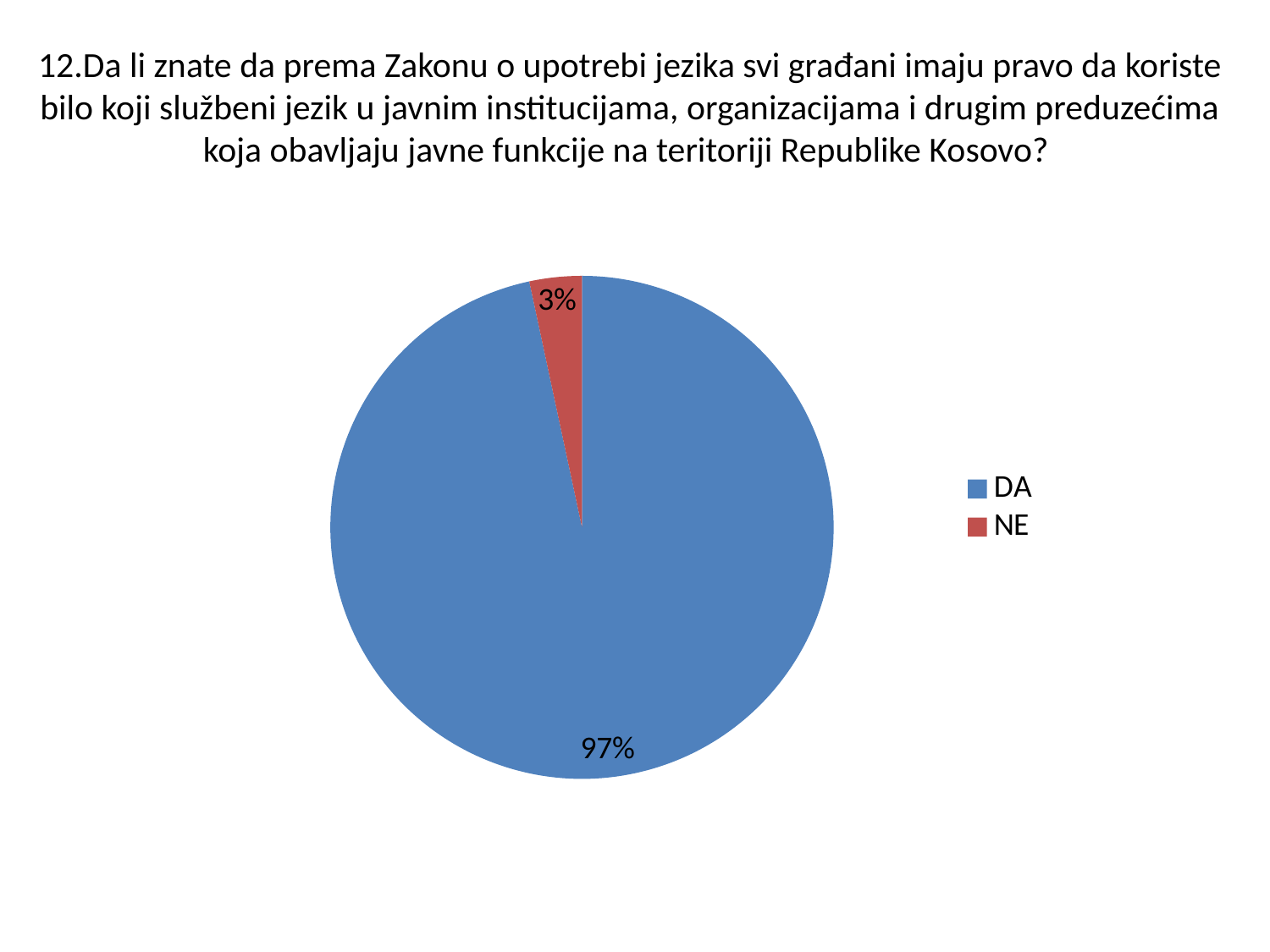
What percentage of the pie is labelled NE? 3% What share of the pie does the NE slice represent? 3% What kind of chart is shown on the slide? pie chart Which slice is larger, DA or NE? DA What is the difference in percentage points between the DA and NE slices? 94 How many slices does the pie chart have? 2 What percentage of the pie is labelled DA? 97% How many entries does the legend list? 2 What colour is the DA slice? blue Which category has the smallest share of the pie? NE What colour is the NE slice? red Which category has the largest share of the pie? DA